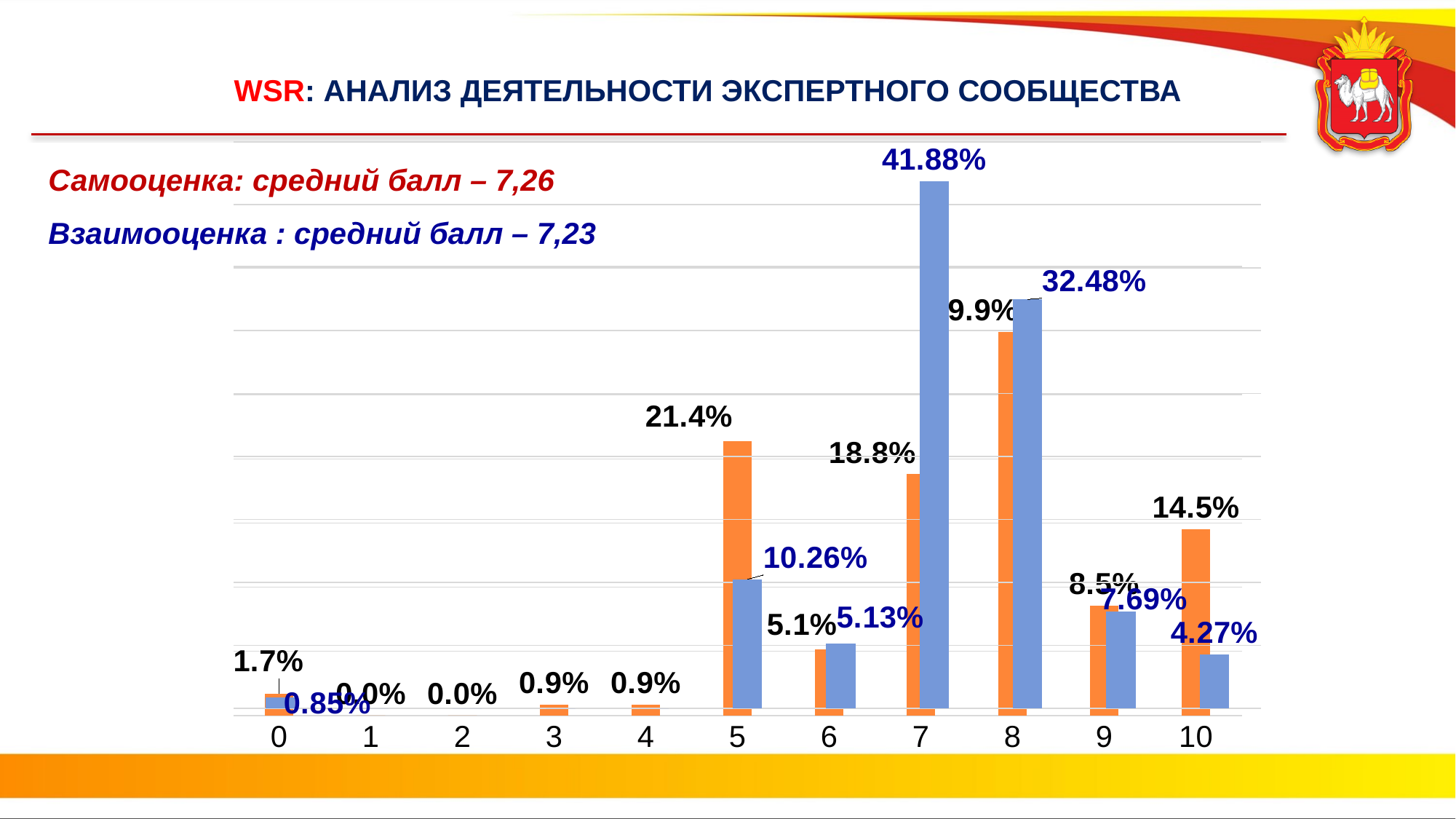
How many score categories are shown on the x axis of the chart? 11 What kind of chart is shown on the slide? bar chart What is the value of the blue bar for score 10? 4.27% What is the value of the blue bar for score 7? 41.88% What is the value of the orange bar for score 0? 1.7% What is the value of the orange bar for score 10? 14.5% What is the value of the orange bar for score 5? 21.4% For which score is the blue bar highest? 7 What is the value of the blue bar for score 9? 7.69% For score 5, what is the difference between the orange bar and the blue bar? 11.14 percentage points For score 7, which bar is larger, the orange or the blue? blue For which score is the orange bar highest? 8